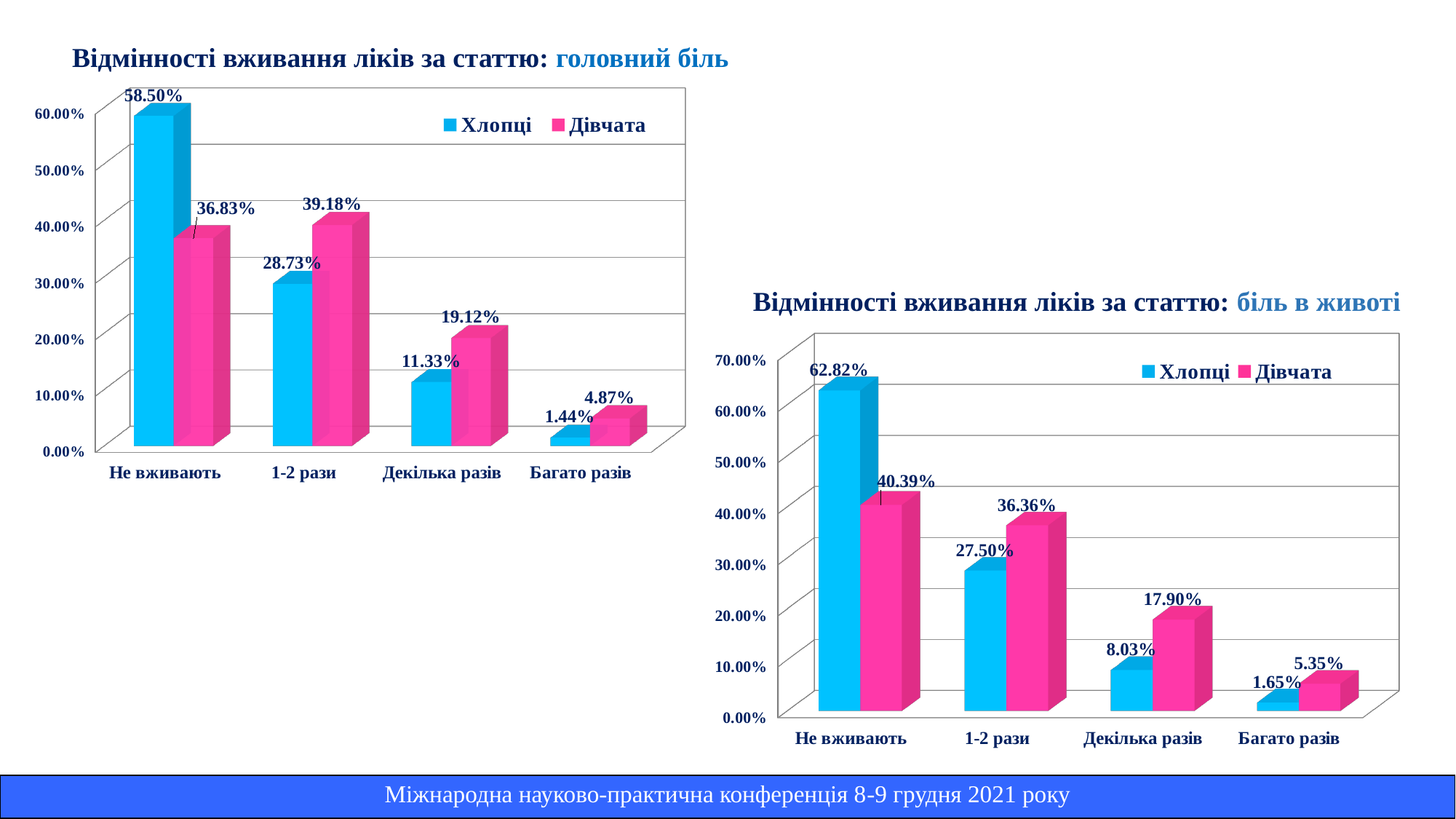
In the chart titled 'Відмінності вживання ліків за статтю: головний біль', which is larger in the 'Декілька разів' category: Хлопці or Дівчата? Дівчата In the chart titled 'Відмінності вживання ліків за статтю: головний біль', which category has the lowest value for Хлопці? Багато разів How many categories are shown on the x axis of the chart titled 'Відмінності вживання ліків за статтю: біль в животі'? 4 What kind of chart is the one titled 'Відмінності вживання ліків за статтю: біль в животі'? Bar chart In the chart titled 'Відмінності вживання ліків за статтю: біль в животі', which category has the highest value for Дівчата? Не вживають How many series does the legend list in the chart titled 'Відмінності вживання ліків за статтю: головний біль'? 2 In the chart titled 'Відмінності вживання ліків за статтю: головний біль', what is the value for Дівчата in the '1-2 рази' category? 39.18% In the chart titled 'Відмінності вживання ліків за статтю: біль в животі', what is the value for Дівчата in the 'Декілька разів' category? 17.90% In the chart titled 'Відмінності вживання ліків за статтю: біль в животі', what is the value for Хлопці in the 'Багато разів' category? 1.65% In the chart titled 'Відмінності вживання ліків за статтю: головний біль', what is the value for Хлопці in the 'Не вживають' category? 58.50% In the chart titled 'Відмінності вживання ліків за статтю: біль в животі', what is the difference between the Дівчата and Хлопці values in the '1-2 рази' category? 8.86% In the chart titled 'Відмінності вживання ліків за статтю: головний біль', what is the difference between the Хлопці and Дівчата values in the 'Не вживають' category? 21.67%